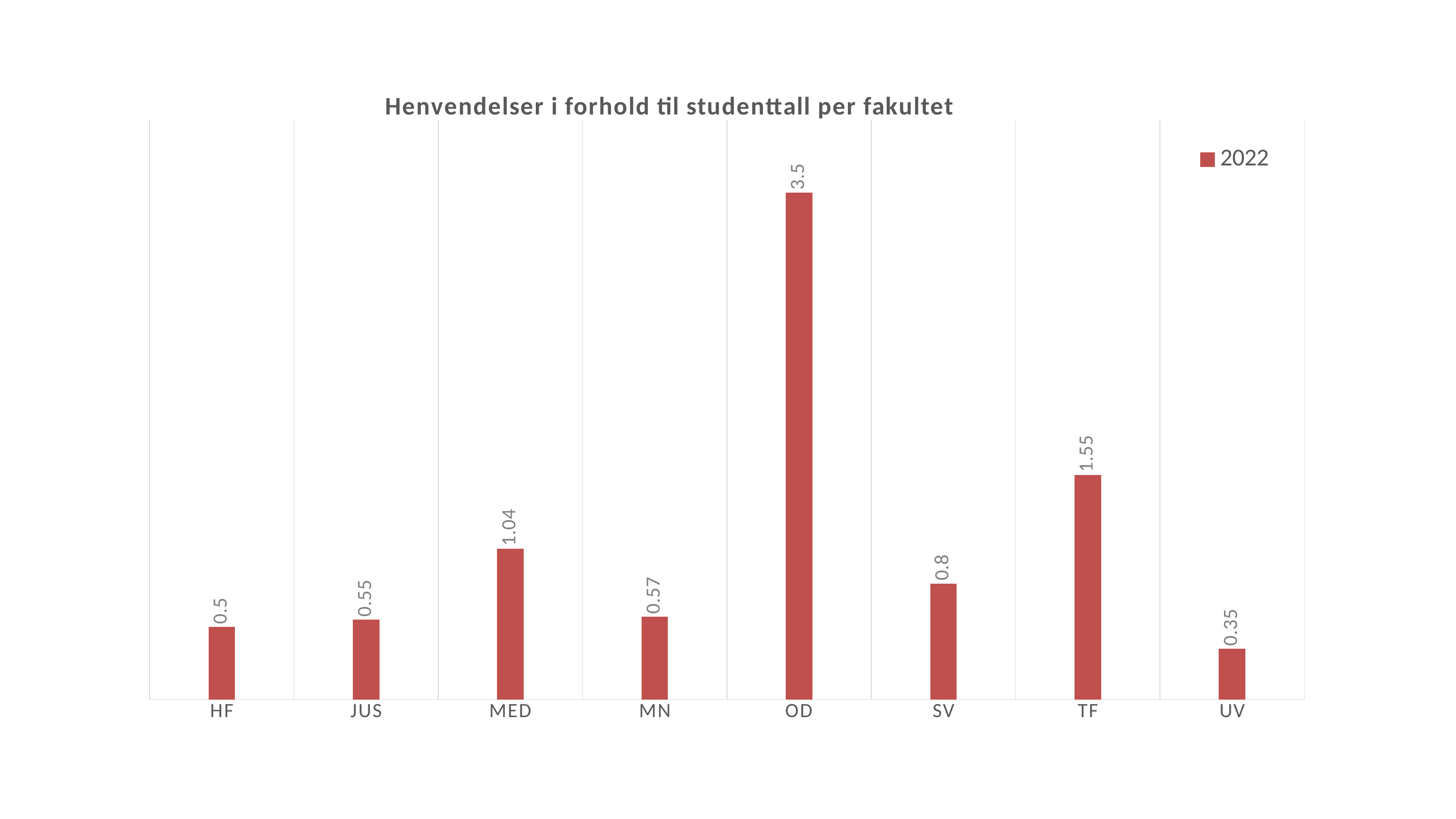
What is the value for UV? 0.35 What is the value for OD? 3.5 What is the difference between the values for SV and HF? 0.3 How many faculties are shown on the x axis? 8 What kind of chart is this? Bar chart Which faculty has the lowest value? UV Which is larger, the value for MED or the value for SV? MED Which faculty has the highest value? OD What is the difference between the values for OD and TF? 1.95 How many series does the legend list? 1 What is the value for MED? 1.04 What is the value for TF? 1.55